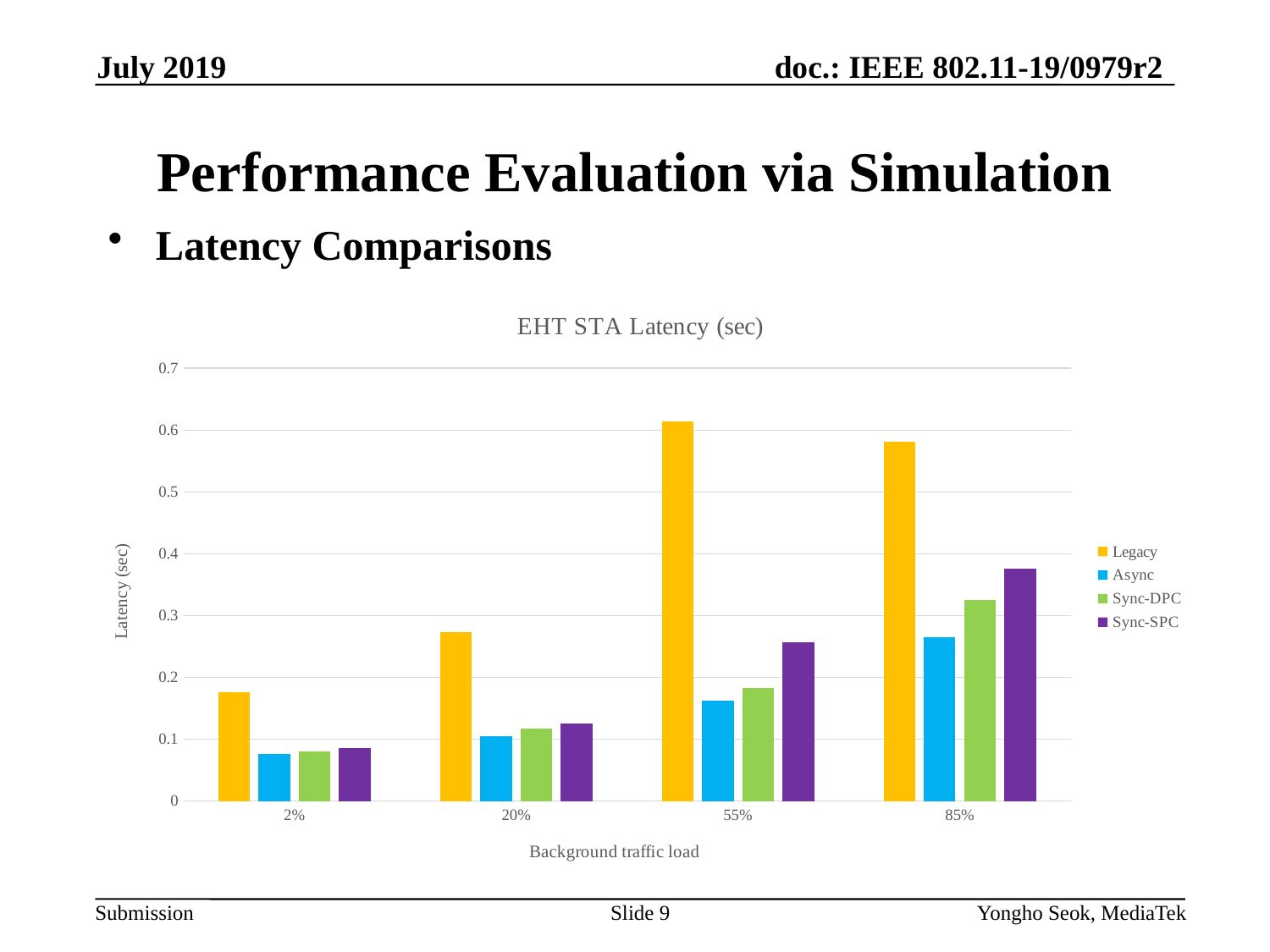
Which series has the lowest latency at 55% background traffic load? Async At 85% background traffic load, which has the higher latency, Sync-DPC or Sync-SPC? Sync-SPC How many background traffic load categories are shown on the x axis? 4 What kind of chart is shown on the slide? bar chart How many series does the legend list? 4 Is the Legacy latency at 20% background traffic load greater or less than 0.3? less Is the Sync-SPC latency at 85% background traffic load greater or less than 0.4? less Does the Async latency rise or fall as the background traffic load increases from 2% to 85%? rise At which background traffic load is the Legacy latency highest? 55% Is the Legacy latency at 55% background traffic load greater or less than 0.6? greater What is the title of the chart? EHT STA Latency (sec) At which background traffic load is the Async latency lowest? 2%